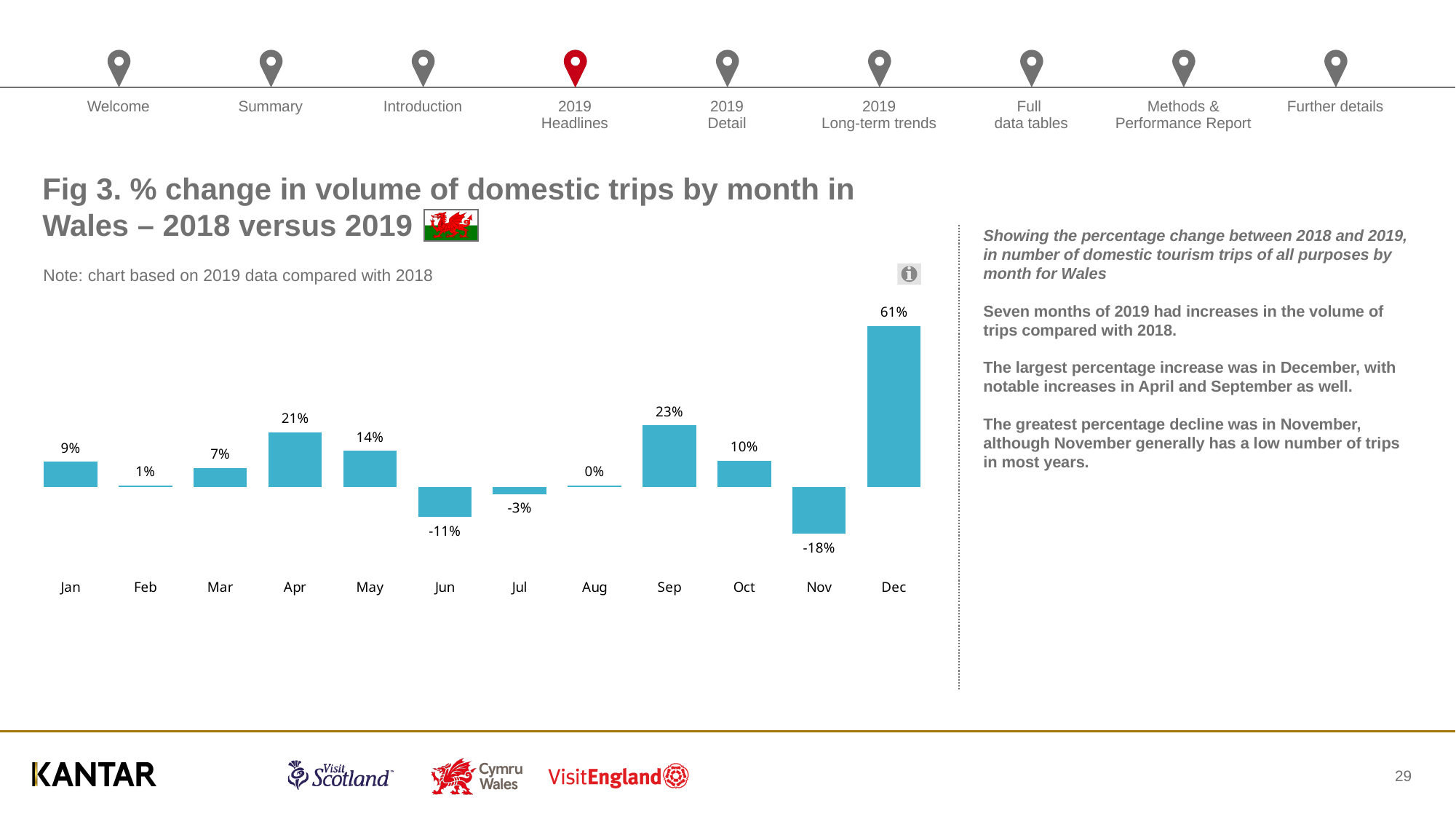
How many months show a negative % change in volume of domestic trips? 3 What is the % change in volume of domestic trips for December? 61% What kind of chart is shown on the slide? Bar chart What is the title of the chart? Fig 3. % change in volume of domestic trips by month in Wales – 2018 versus 2019 What is the difference between the % change for September and the % change for October? 13 percentage points What is the % change in volume of domestic trips for April? 21% Which month has the highest % change in volume of domestic trips? Dec Which month has a larger % change in volume of domestic trips, May or March? May How many months are shown on the chart? 12 What is the % change in volume of domestic trips for November? -18% What is the % change in volume of domestic trips for August? 0% Which month has the lowest % change in volume of domestic trips? Nov